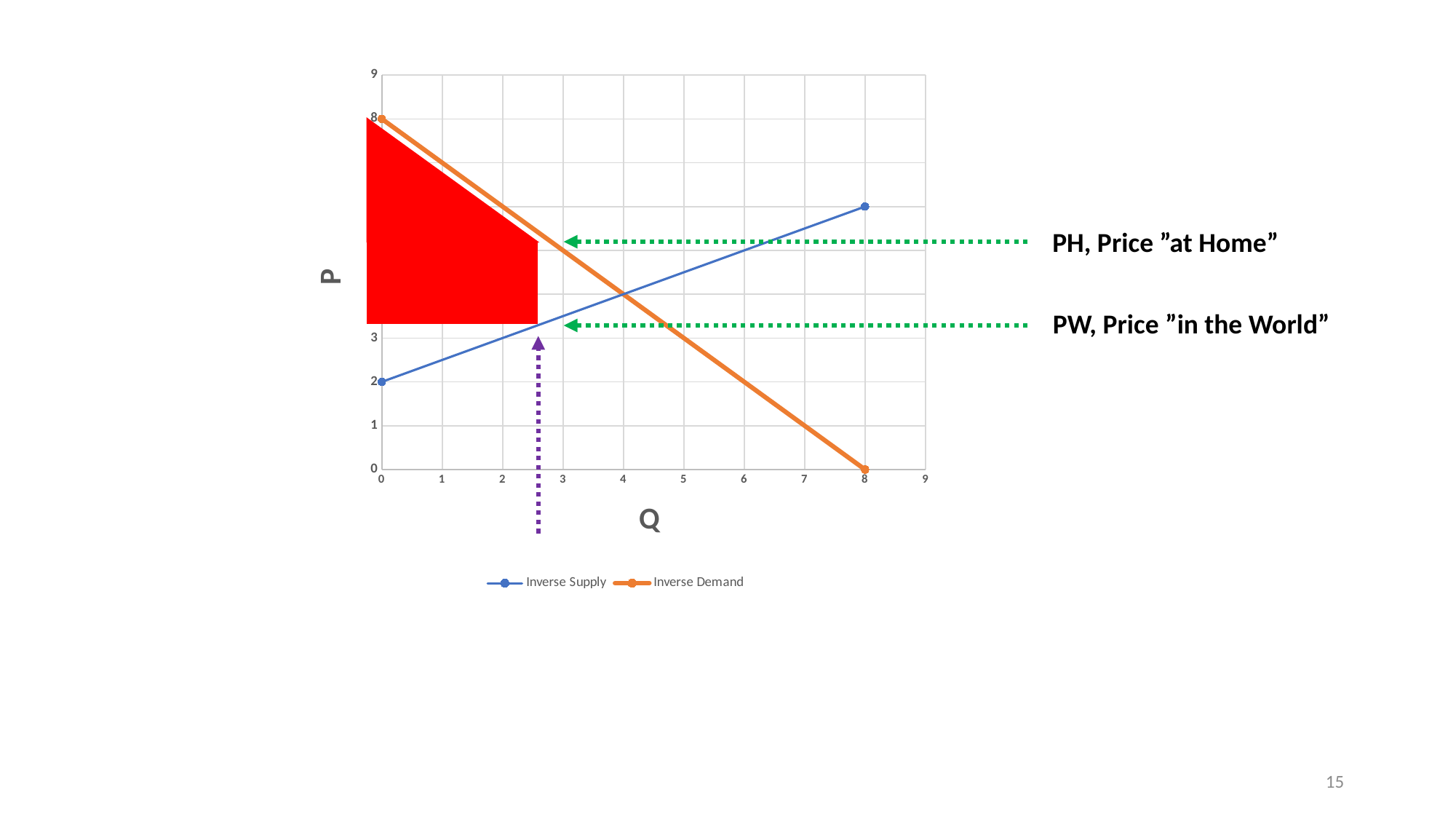
What are the two series named in the legend? Inverse Supply and Inverse Demand How many series does the legend list? 2 What is the value of Inverse Demand at Q = 8? 0 What is the value of Inverse Supply at Q = 0? 2 At Q = 8, which series has the higher value, Inverse Supply or Inverse Demand? Inverse Supply Does the Inverse Supply line rise or fall as Q increases? rises Is the value of Inverse Supply at Q = 8 greater or less than 3? greater At Q = 0, which series has the higher value, Inverse Supply or Inverse Demand? Inverse Demand What kind of chart is shown on the slide? line chart Does the Inverse Demand line rise or fall as Q increases? falls What are the labels of the x axis and the y axis? Q and P What is the value of Inverse Demand at Q = 0? 8